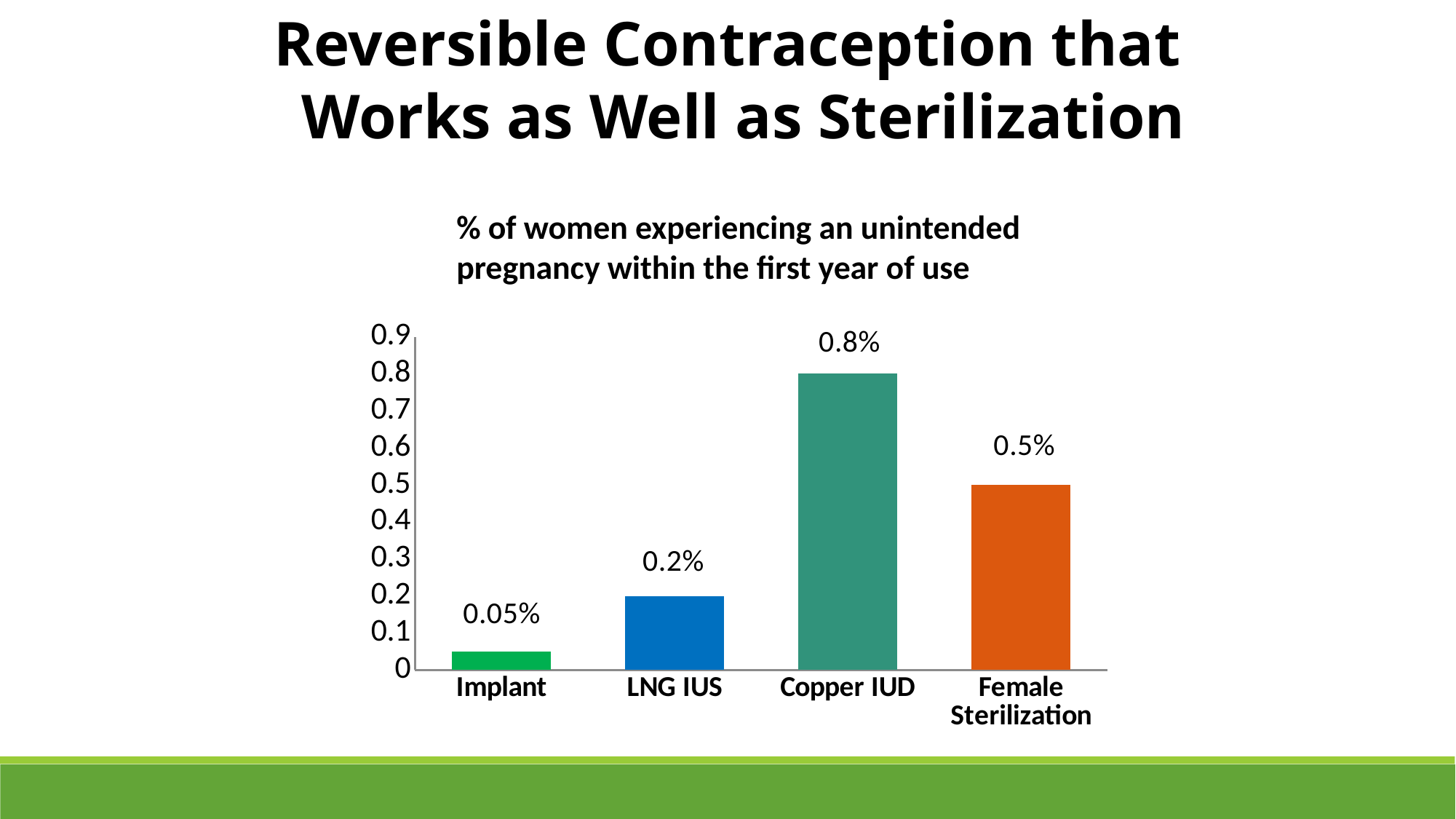
What is the value for Implant? 0.05% What is the value for Copper IUD? 0.8% What kind of chart is shown on the slide? bar chart Is the value for Copper IUD greater or less than 0.7? greater Which category has the lowest value? Implant Which is larger, the value for LNG IUS or the value for Female Sterilization? Female Sterilization What is the title of the chart? % of women experiencing an unintended pregnancy within the first year of use What is the value for Female Sterilization? 0.5% Which category has the highest value? Copper IUD What is the value for LNG IUS? 0.2% How many categories are shown on the x axis? 4 What is the difference between the values for Copper IUD and Female Sterilization? 0.3%